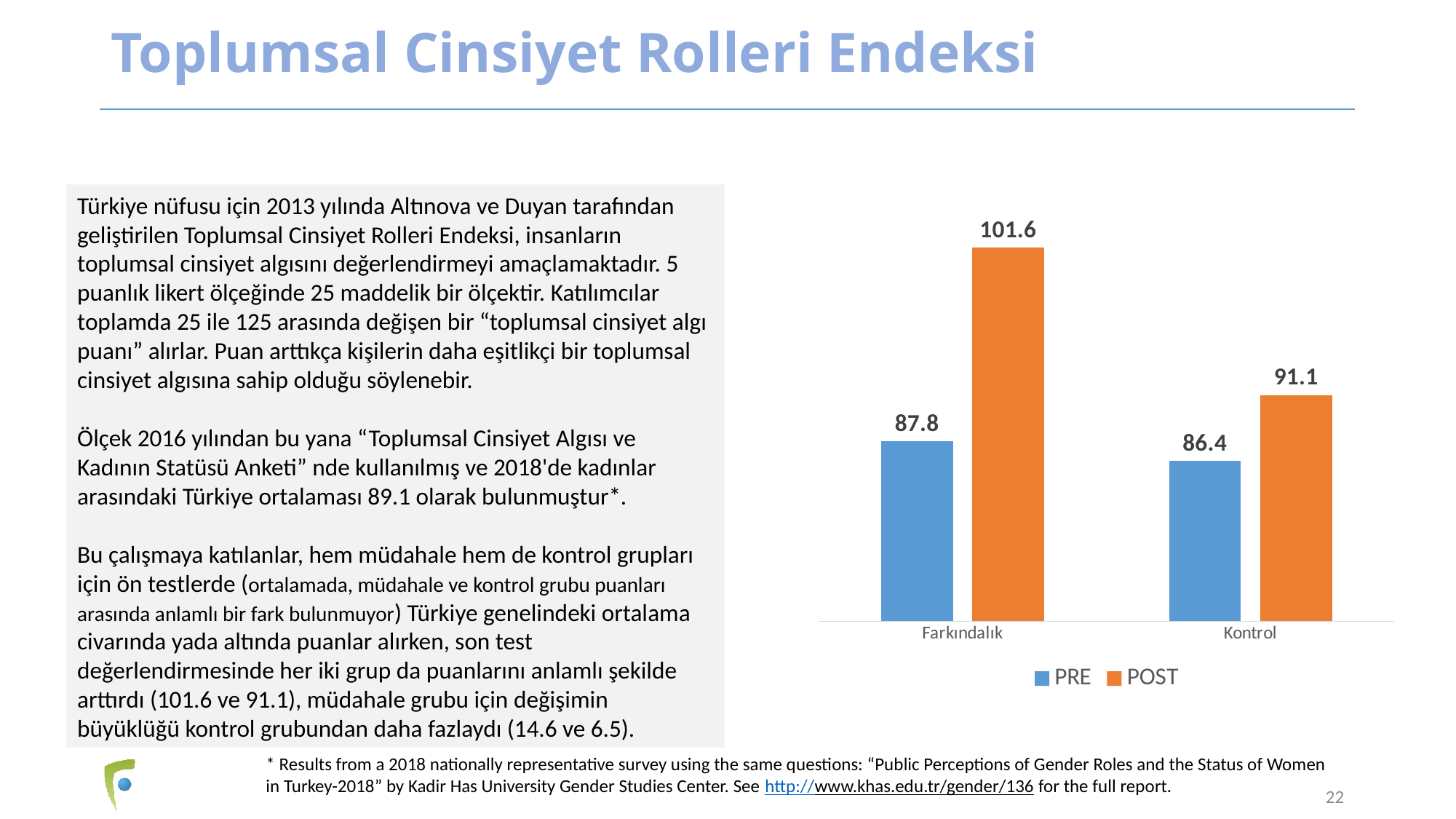
How many categories are shown on the x axis? 2 What kind of chart is shown on the slide? Bar chart Which bar has the lowest value in the chart? PRE for Kontrol What is the PRE value for Farkındalık? 87.8 What is the POST value for Kontrol? 91.1 How many series does the legend list? 2 Which bar has the highest value in the chart? POST for Farkındalık Which is larger, the POST value for Farkındalık or the POST value for Kontrol? POST for Farkındalık What is the PRE value for Kontrol? 86.4 What is the POST value for Farkındalık? 101.6 What is the difference between the POST and PRE values for Farkındalık? 13.8 What is the difference between the POST and PRE values for Kontrol? 4.7